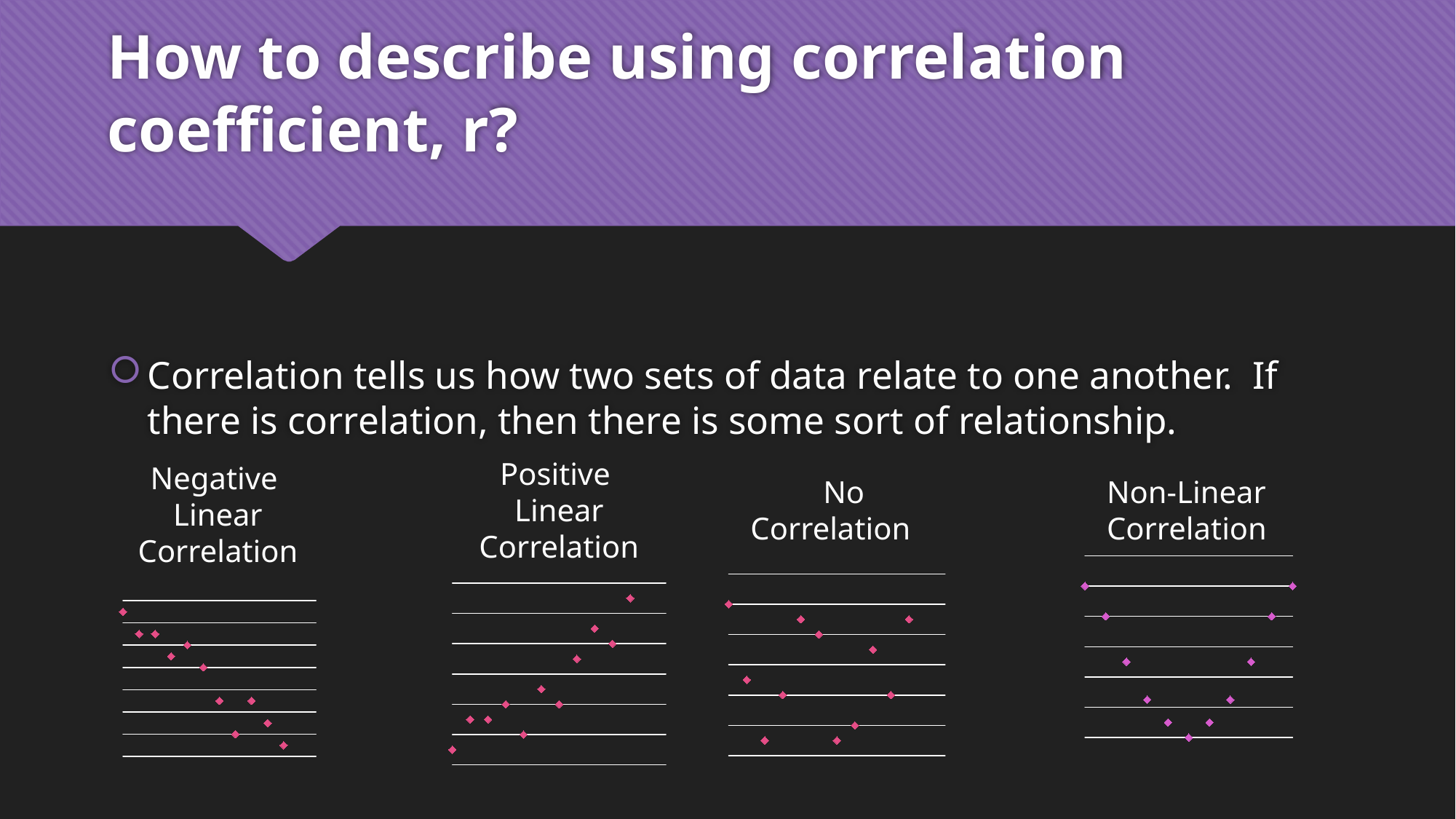
In the chart titled "Non-Linear Correlation", what shape do the points follow from left to right? fall then rise (U-shape) In the chart titled "Positive Linear Correlation", do the points rise or fall from left to right? rise In the chart titled "Negative Linear Correlation", do the points rise or fall from left to right? fall How many points are plotted in the chart titled "Positive Linear Correlation"? 11 What is the title of the rightmost chart on the slide? Non-Linear Correlation What kind of chart is the one titled "Negative Linear Correlation"? scatter chart How many points are plotted in the chart titled "Negative Linear Correlation"? 11 What is the title of the leftmost chart on the slide? Negative Linear Correlation What kind of chart is the one titled "No Correlation"? scatter chart How many charts are shown on the slide? 4